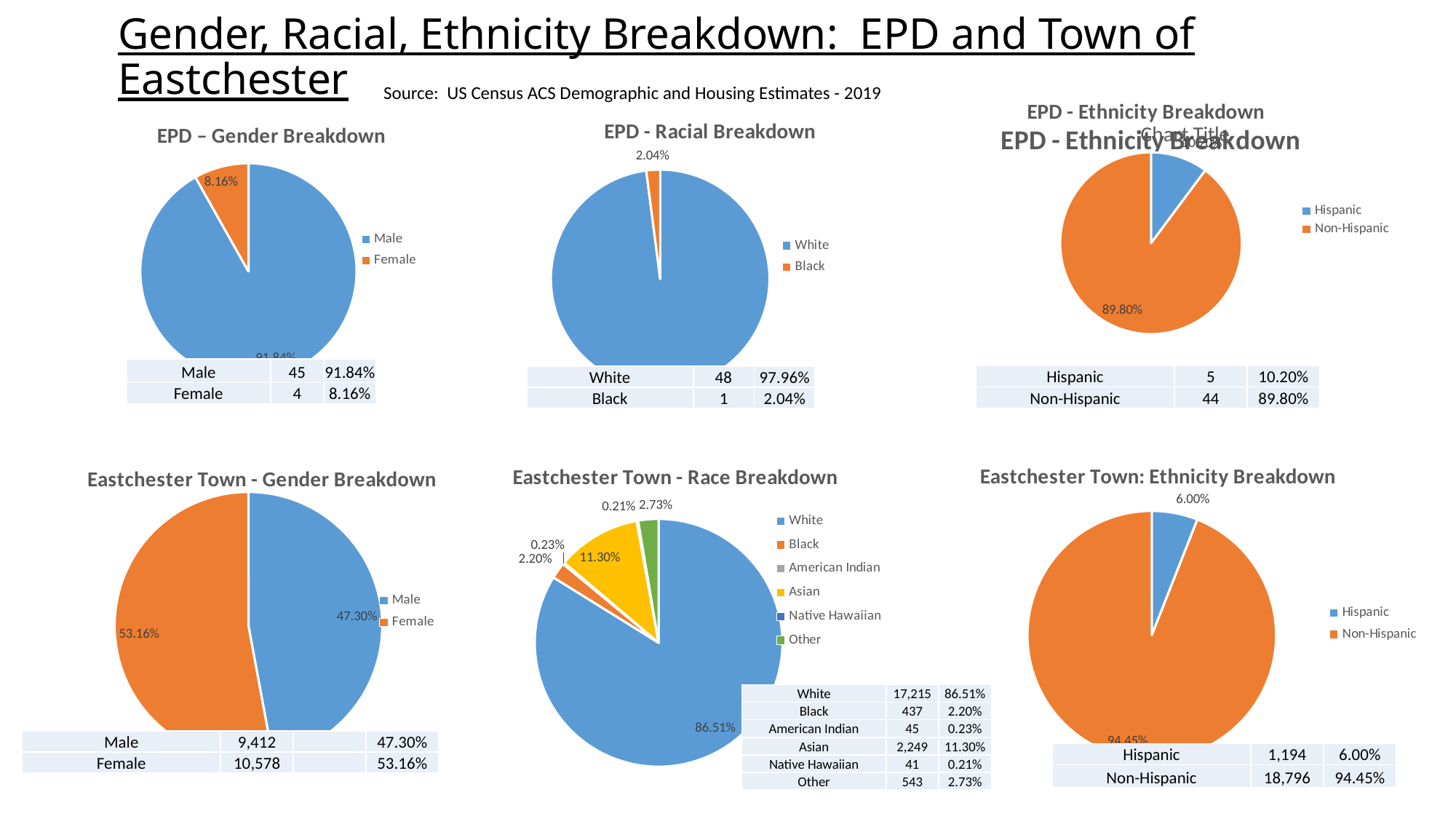
In the EPD - Ethnicity Breakdown chart, what percentage is Non-Hispanic? 89.80% In the Eastchester Town - Race Breakdown chart, what colour is the Asian slice? Yellow In the Eastchester Town - Race Breakdown chart, what percentage is Asian? 11.30% In the EPD – Gender Breakdown chart, what percentage of the pie is Female? 8.16% In the Eastchester Town - Race Breakdown chart, which category has the smallest share? Native Hawaiian In the EPD - Racial Breakdown chart, which category has the largest share? White In the Eastchester Town: Ethnicity Breakdown chart, what percentage is Hispanic? 6.00% In the Eastchester Town - Gender Breakdown chart, which category is larger, Male or Female? Female What kind of chart is the Eastchester Town - Gender Breakdown chart? Pie chart In the Eastchester Town - Gender Breakdown chart, what is the difference in percentage points between Female and Male? 5.86 How many categories does the legend of the Eastchester Town - Race Breakdown chart list? 6 In the EPD - Racial Breakdown chart, what share of the pie is Black? 2.04%